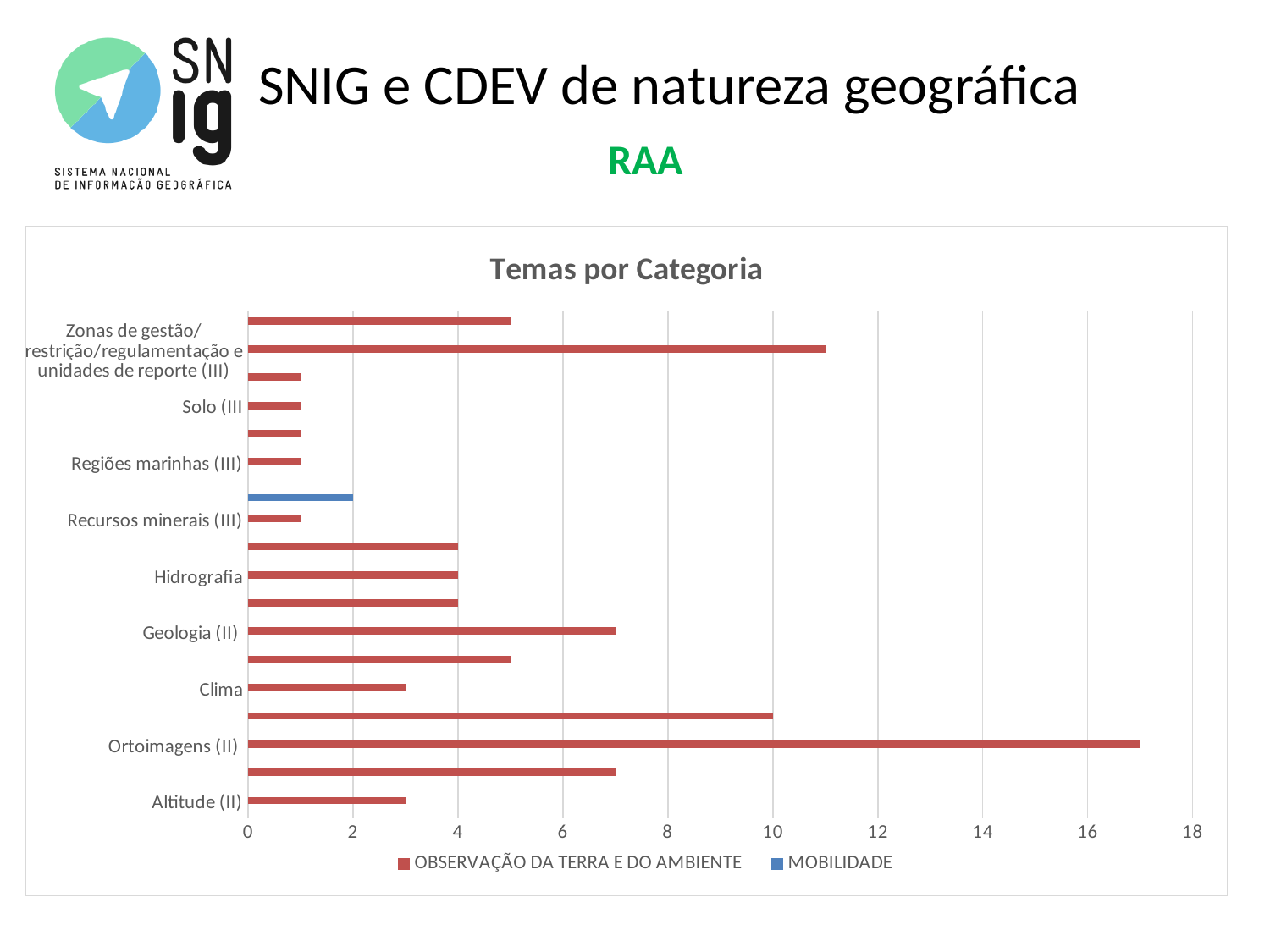
What type of chart is shown on the slide? bar chart Is the value for Altitude (II) greater or less than 4? less What is the title of the chart? Temas por Categoria Is the value for Ortoimagens (II) greater or less than 16? greater How many series does the chart legend list? 2 Which has the larger value, Ortoimagens (II) or Geologia (II)? Ortoimagens (II) How many category labels are shown on the vertical axis of the chart? 9 What is the value of the bar for Hidrografia? 4 Which labelled category has the longest bar in the chart? Ortoimagens (II) What is the value of the single MOBILIDADE bar in the chart? 2 Is the value for Geologia (II) greater or less than 6? greater Which series is shown in blue in the chart legend? MOBILIDADE